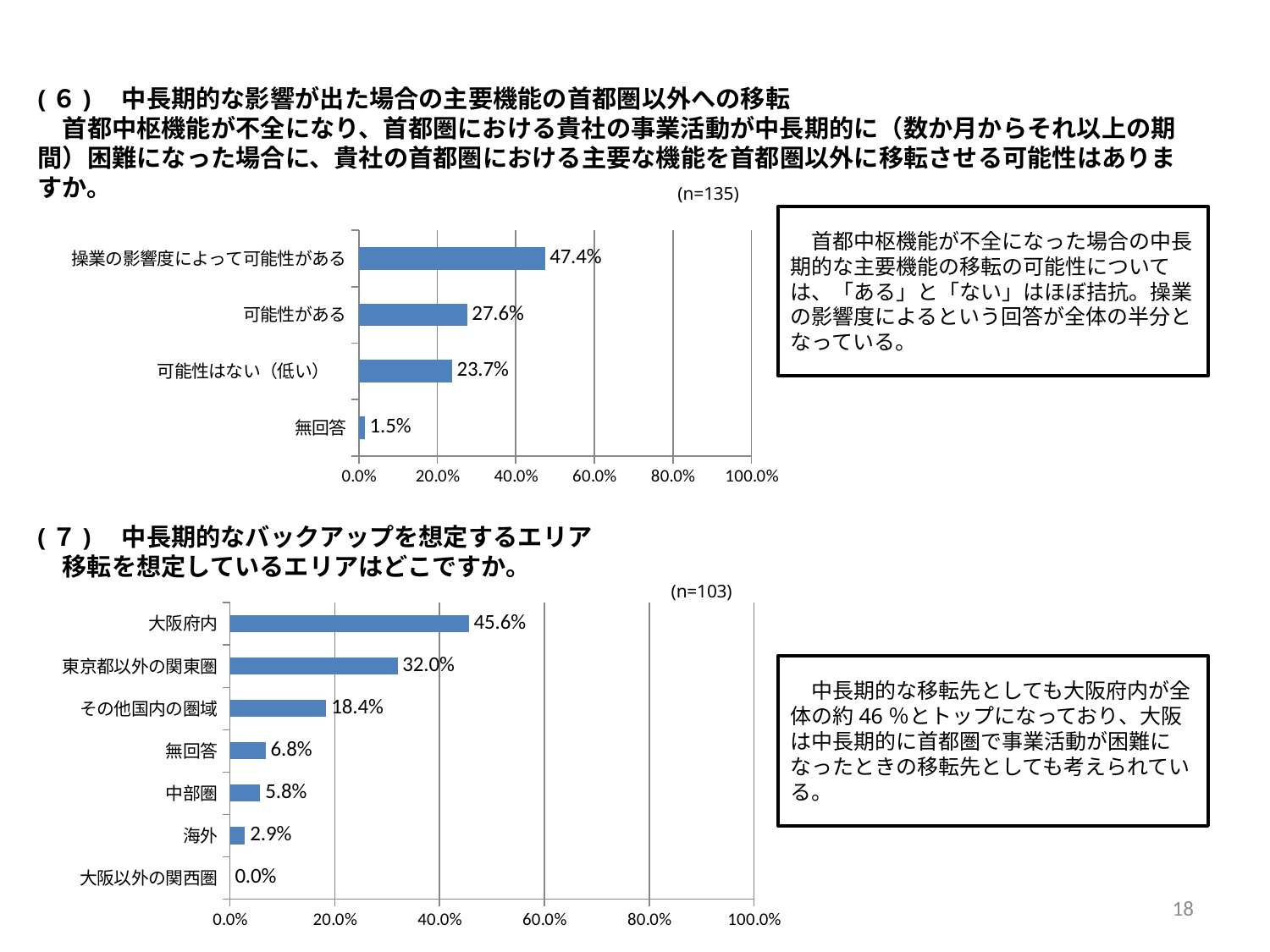
In the top chart (6), how many categories are shown? 4 In the top chart (6), what is the difference between 可能性がある and 可能性はない（低い）? 3.9% In the bottom chart (7), how many categories are shown? 7 In the top chart (6), which category has the lowest value? 無回答 In the top chart (6), what is the value for 操業の影響度によって可能性がある? 47.4% In the bottom chart (7), what is the difference between 大阪府内 and その他国内の圏域? 27.2% In the bottom chart (7), what is the sample size (n) shown above the chart? n=103 In the bottom chart (7), which is larger, 中部圏 or 海外? 中部圏 In the top chart (6), what kind of chart is it? bar chart In the bottom chart (7), which category has the lowest value? 大阪以外の関西圏 In the bottom chart (7), which category has the highest value? 大阪府内 In the bottom chart (7), what is the value for 東京都以外の関東圏? 32.0%